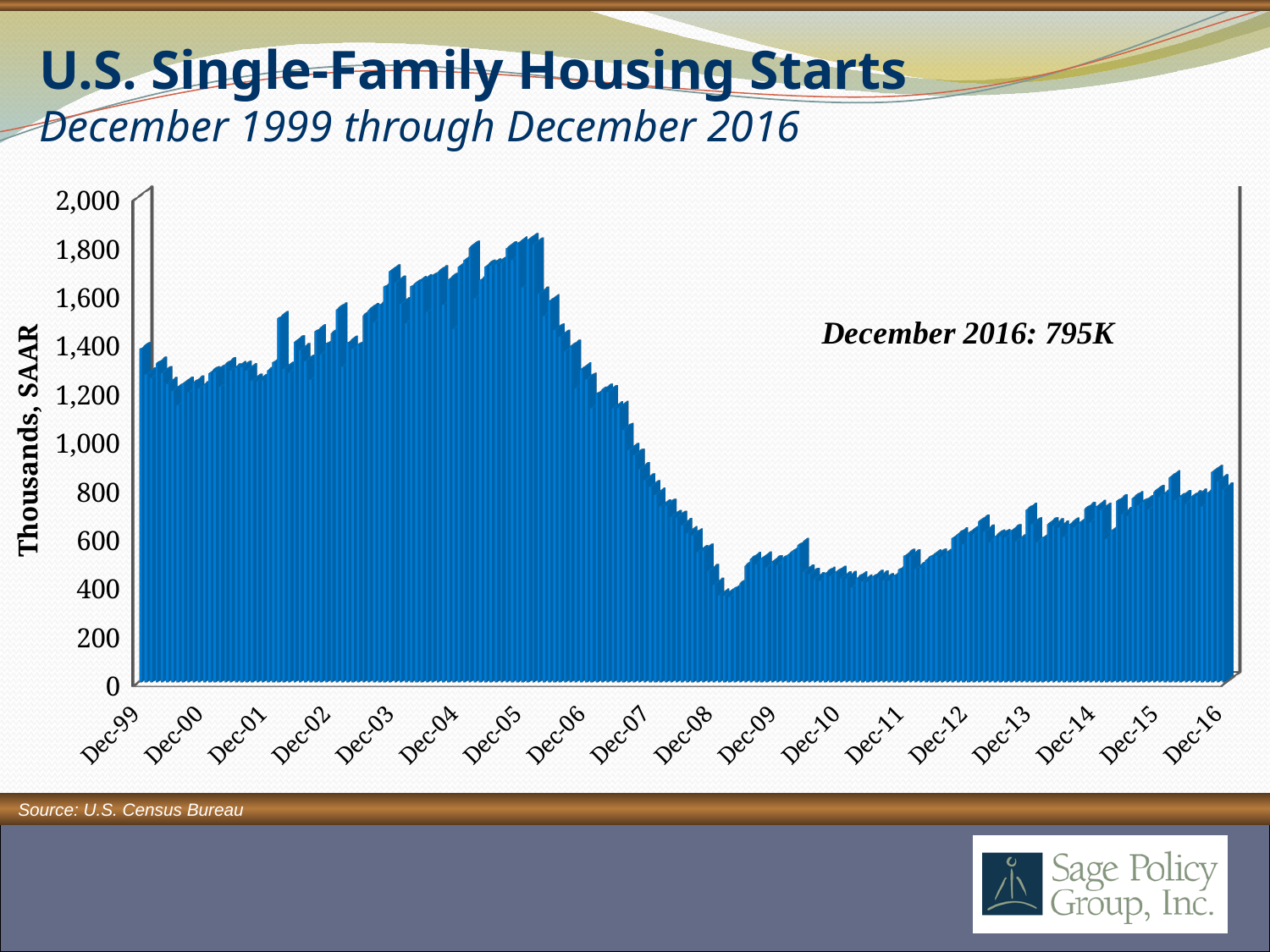
What kind of chart is shown on the slide? Bar chart What value does the annotation give for December 2016? 795K Which is larger, the value at Dec-05 or the value at Dec-10? Dec-05 Is the lowest bar on the chart greater or less than 600? less Is the value at Dec-99 greater or less than 1,200? greater Is the value at Dec-10 greater or less than 600? less What is the label on the vertical axis? Thousands, SAAR How many date labels are shown along the x axis? 18 Near which x-axis label does the chart reach its highest values? Dec-05 Do the values rise or fall between Dec-05 and Dec-08? Fall What is the source cited for the chart? U.S. Census Bureau